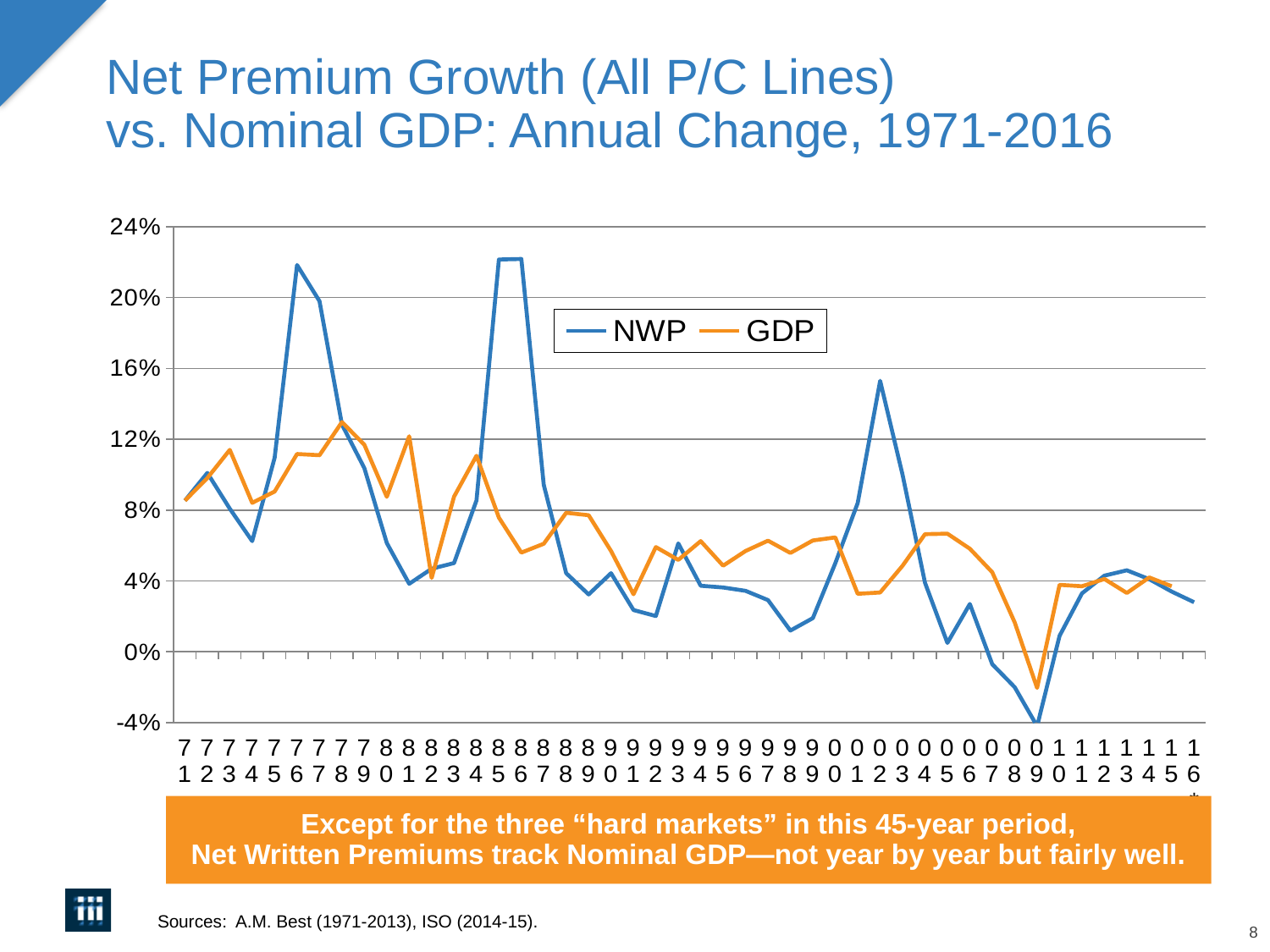
In 1986, which series has the larger value, NWP or GDP? NWP How many series does the legend list? 2 Is the NWP value for 2009 greater or less than 0%? less What kind of chart is shown on the slide? line chart In which year does the NWP line reach its lowest value? 2009 Is the NWP value for 2002 greater or less than 12%? greater How many years are plotted along the x axis? 46 Is the NWP value for 1986 greater or less than 20%? greater What are the two series named in the legend? NWP and GDP Which colour is used for the NWP line? blue